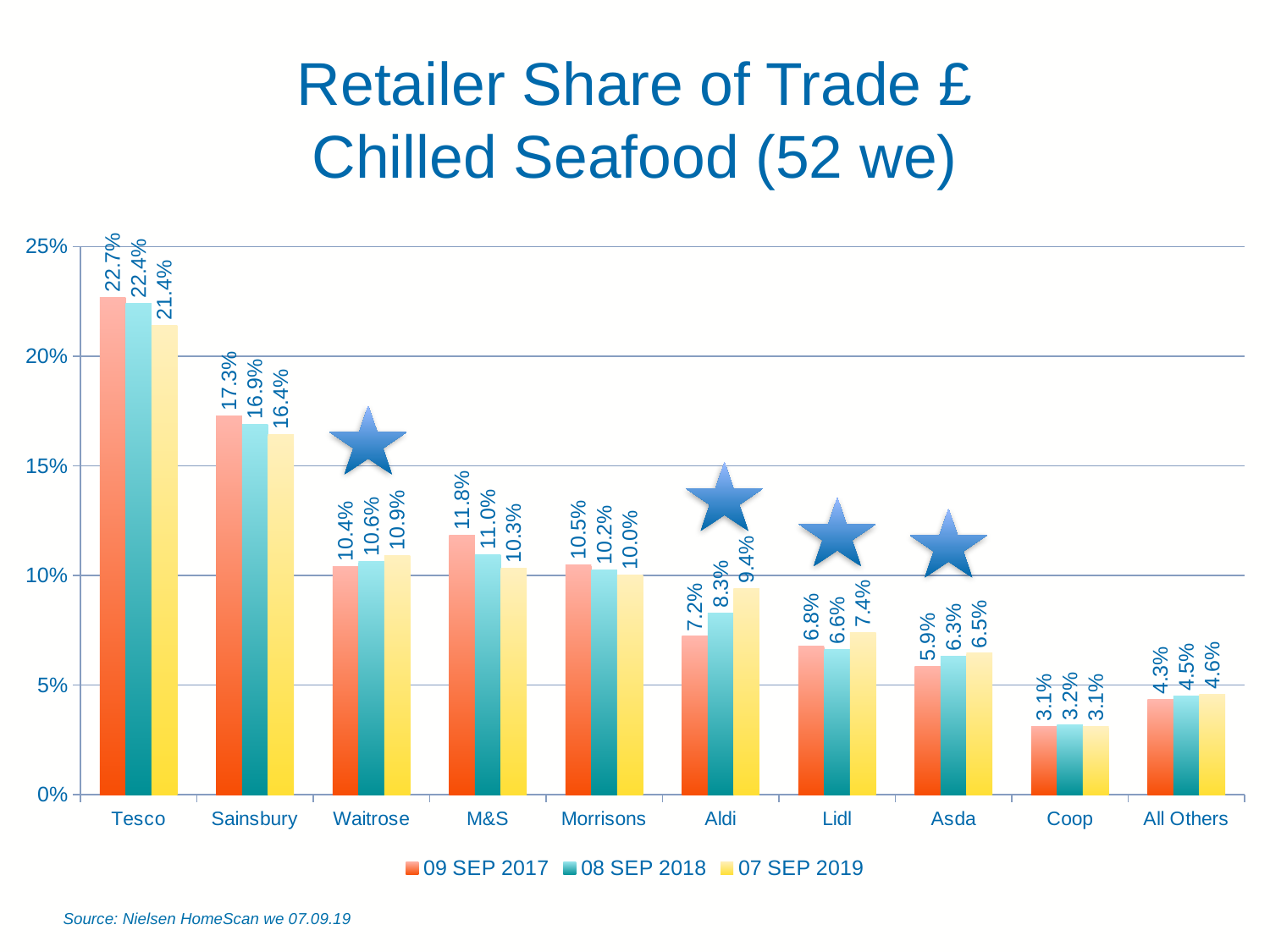
What is the difference between Sainsbury's share in 09 SEP 2017 and 07 SEP 2019? 0.9% What is Aldi's share of trade for 09 SEP 2017? 7.2% How many retailer categories are shown on the x axis? 10 How many series does the legend list? 3 What is the title of the chart? Retailer Share of Trade £ Chilled Seafood (52 we) Which retailer has the lowest share of trade in 09 SEP 2017? Coop Which is larger: Waitrose's share in 07 SEP 2019 or M&S's share in 07 SEP 2019? Waitrose What is Tesco's share of trade for 07 SEP 2019? 21.4% Which retailer has the highest share of trade in 07 SEP 2019? Tesco Does Aldi's share of trade rise or fall from 09 SEP 2017 to 07 SEP 2019? Rise What kind of chart is shown on the slide? Bar chart What is the share of trade for Lidl in 08 SEP 2018? 6.6%